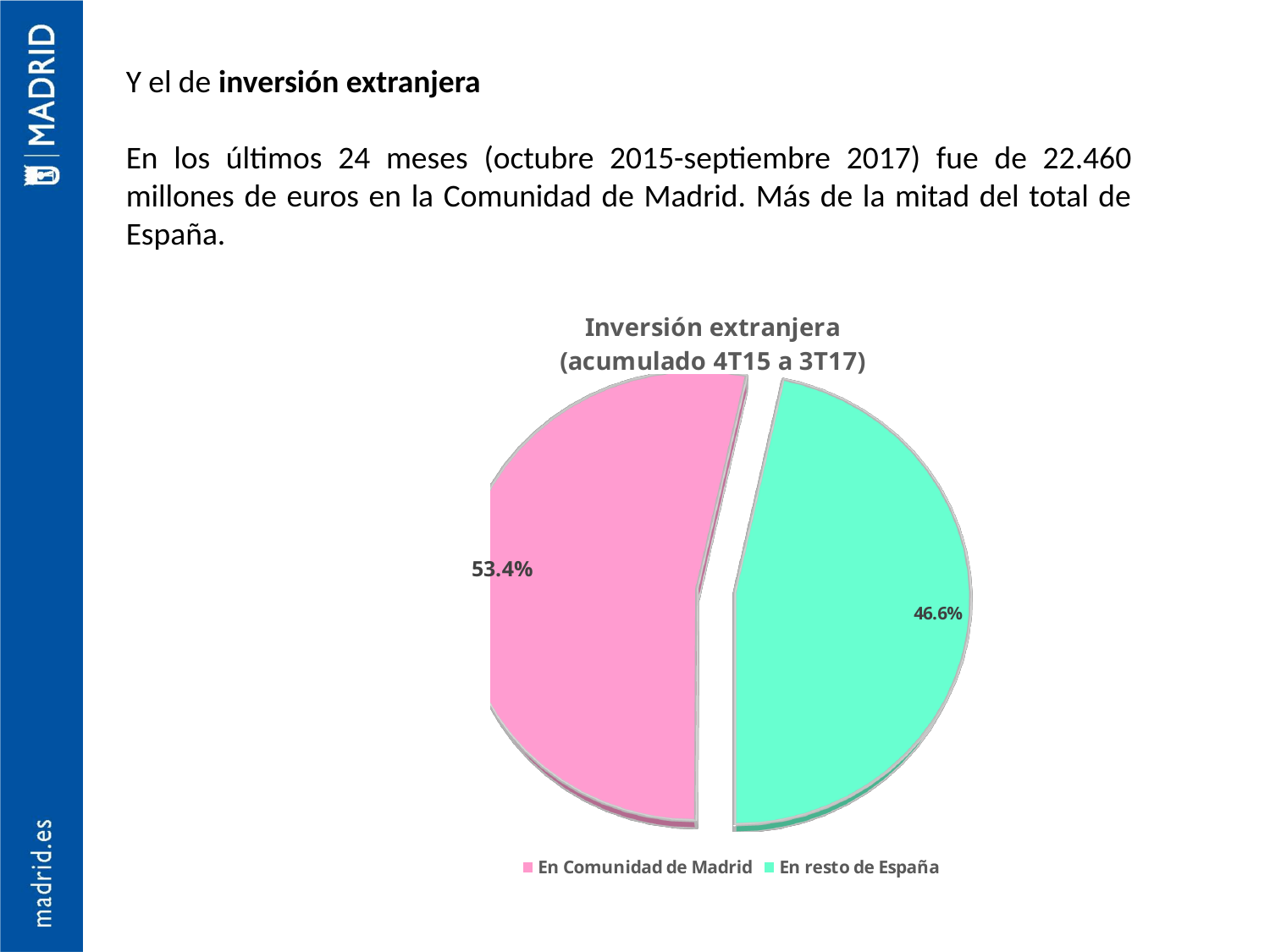
How many slices does the pie chart have? 2 What share of foreign investment does the pie chart show for En Comunidad de Madrid? 53.4% What share of foreign investment does the pie chart show for En resto de España? 46.6% What colour is the En resto de España slice in the pie chart? green What type of chart is shown on the slide? pie chart Which slice of the pie chart is the largest? En Comunidad de Madrid What is the title of the chart? Inversión extranjera (acumulado 4T15 a 3T17) Is the share for En Comunidad de Madrid greater or less than 50%? greater How many entries does the chart legend list? 2 Which is larger, the share for En Comunidad de Madrid or the share for En resto de España? En Comunidad de Madrid What is the difference in percentage points between the En Comunidad de Madrid slice and the En resto de España slice? 6.8 Which slice of the pie chart is the smallest? En resto de España